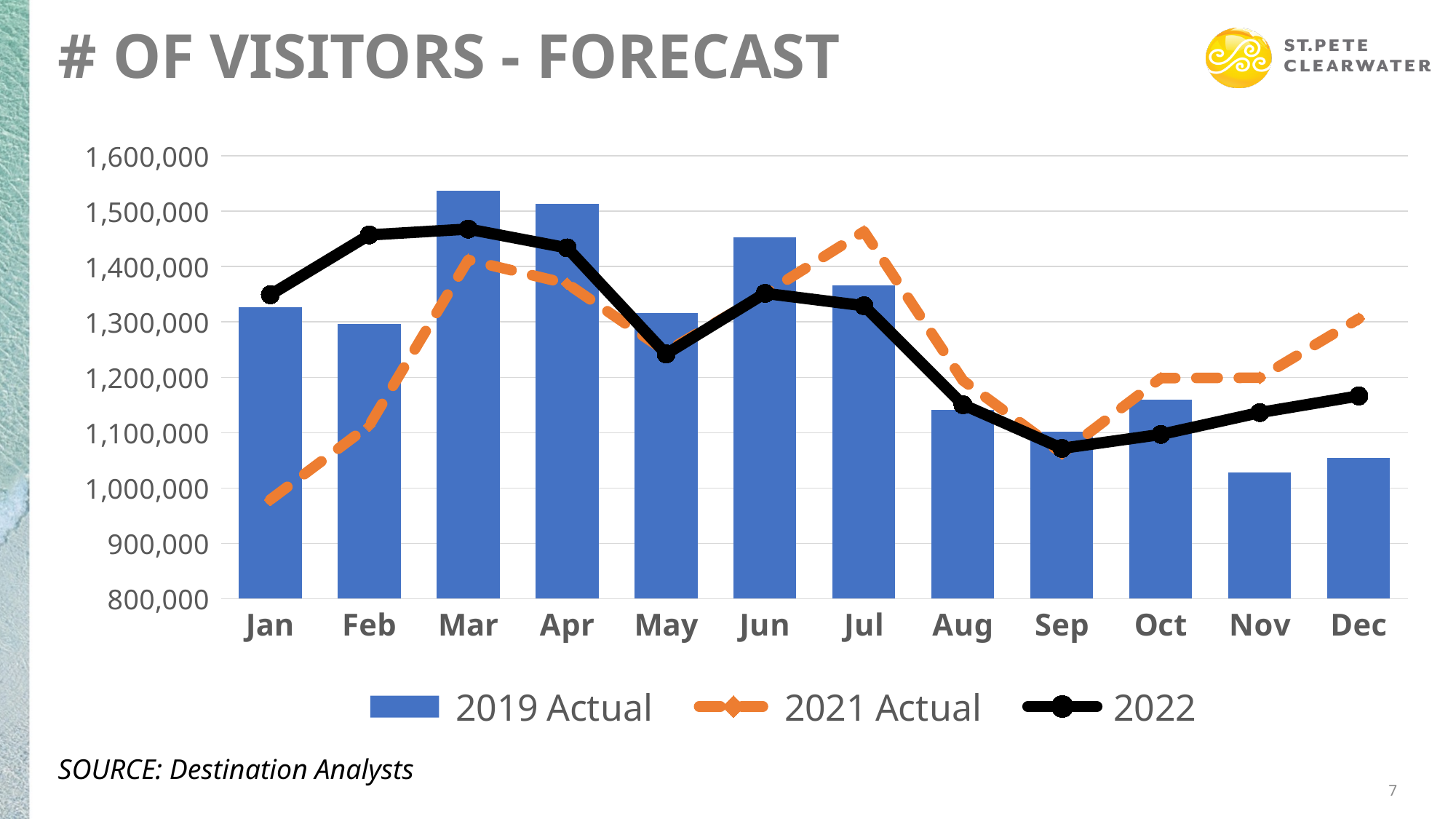
Is the 2019 Actual value for Mar greater or less than 1,500,000? greater What kind of chart is shown on the slide? A combined bar and line chart In Feb, which is larger: the 2019 Actual value or the 2022 value? 2022 Is the 2022 value for Feb greater or less than 1,400,000? greater Is the 2021 Actual value for Jan greater or less than 1,000,000? less Which month has the lowest 2021 Actual value? Jan Which month has the highest 2019 Actual value? Mar In Jul, which is larger: the 2021 Actual value or the 2022 value? 2021 Actual Which month has the highest 2021 Actual value? Jul Which month has the lowest 2019 Actual value? Nov How many series does the legend list? 3 How many months are shown on the x axis? 12